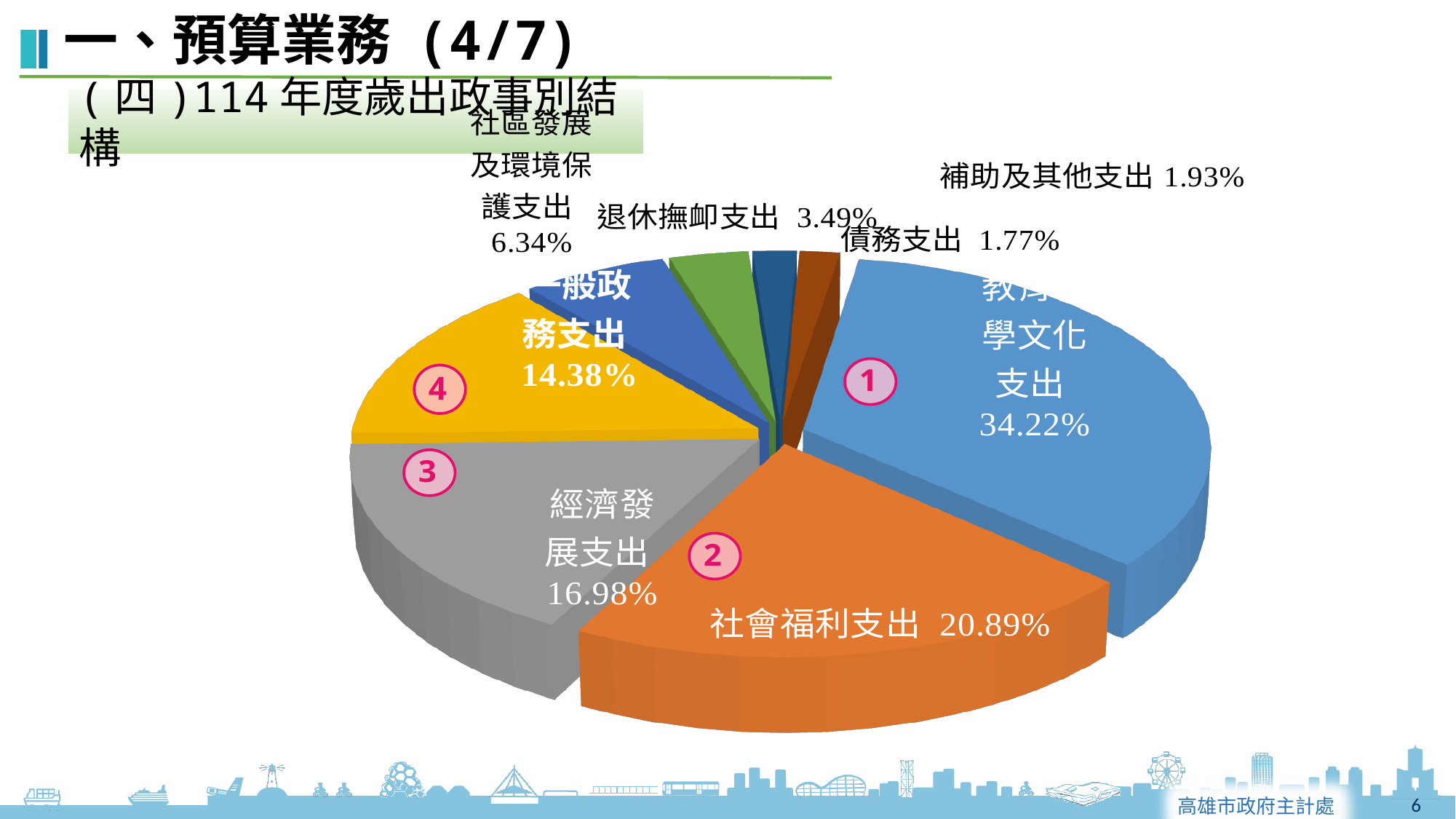
圓餅圖中哪一項支出所占比例最低？ 債務支出 這張圖表是什麼類型的圖表？ 圓餅圖 圓餅圖中標示數字「3」的是哪一項支出？ 經濟發展支出 圓餅圖中教育科學文化支出與社會福利支出的比例相差多少個百分點？ 13.33 圓餅圖中一般政務支出與經濟發展支出，哪一項比例較高？ 經濟發展支出 圓餅圖中社會福利支出所占的比例是多少？ 20.89% 圓餅圖中補助及其他支出與債務支出，哪一項比例較高？ 補助及其他支出 圓餅圖共分為幾個類別？ 8 圓餅圖中哪一項支出所占比例最高？ 教育科學文化支出 圓餅圖中經濟發展支出所占的比例是多少？ 16.98% 圓餅圖中社區發展及環境保護支出所占的比例是多少？ 6.34% 圓餅圖中退休撫卹支出所占的比例是多少？ 3.49%